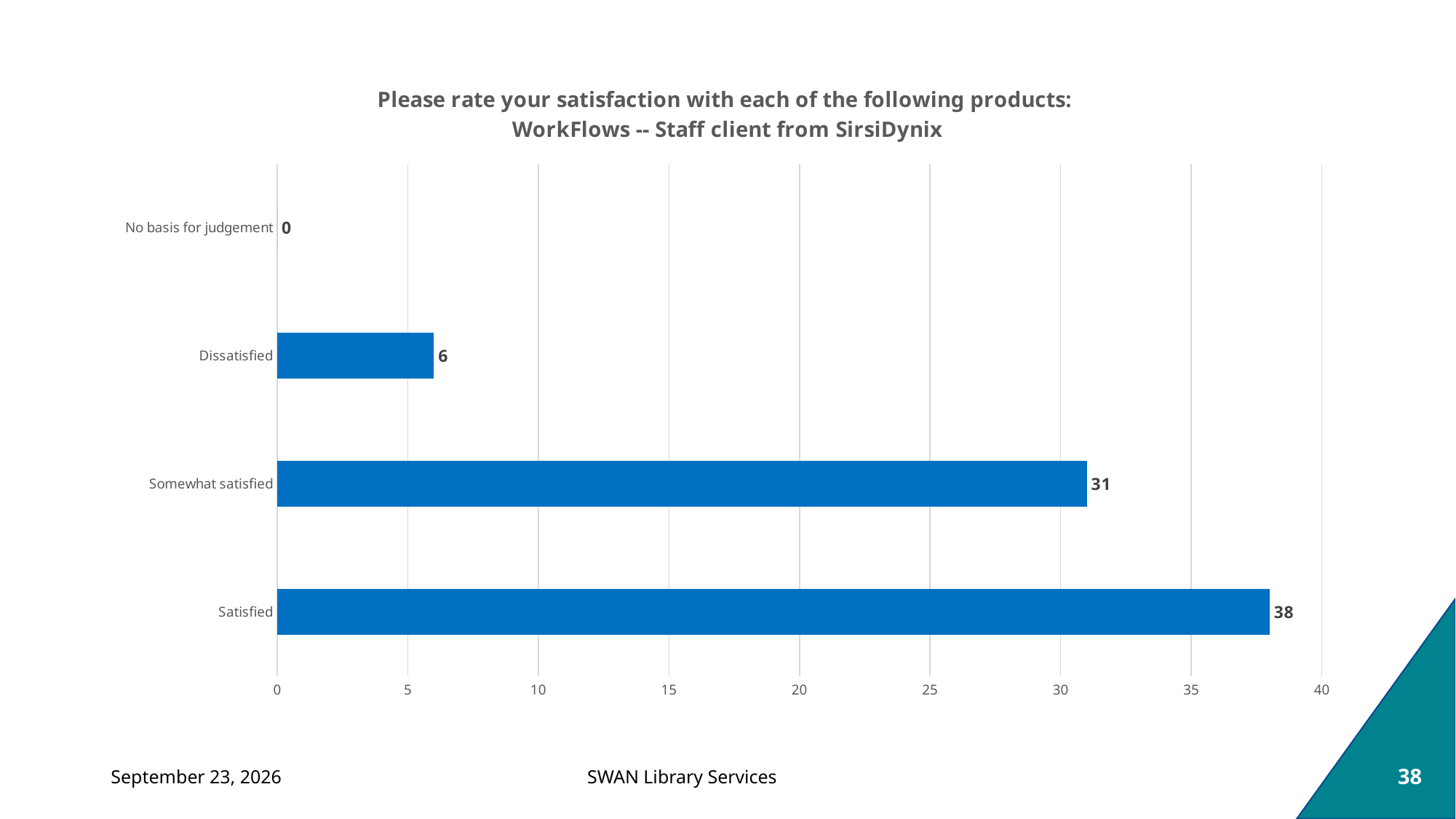
What is the difference between the values for Satisfied and Somewhat satisfied? 7 What is the difference between the values for Somewhat satisfied and Dissatisfied? 25 Which category has the lowest value? No basis for judgement Which category has the highest value? Satisfied What is the value for Dissatisfied? 6 What is the value for Somewhat satisfied? 31 How many categories are shown on the chart? 4 Which product does the chart title say the satisfaction ratings are for? WorkFlows -- Staff client from SirsiDynix What is the value for No basis for judgement? 0 Which is larger, the value for Dissatisfied or the value for Somewhat satisfied? Somewhat satisfied What kind of chart is shown on the slide? Bar chart What is the value for Satisfied? 38